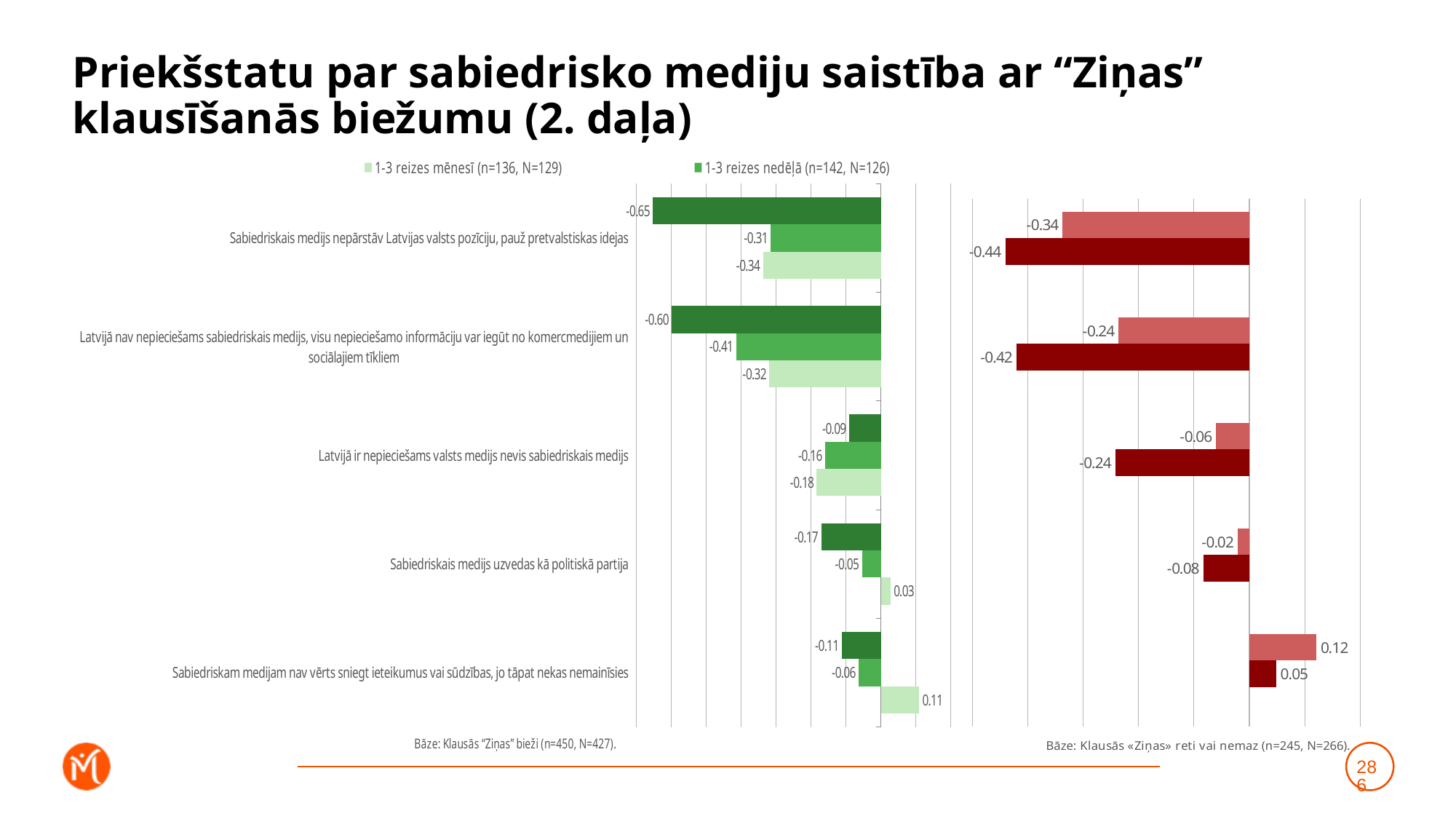
In the left chart, what is the value of the "1-3 reizes nedēļā" series for "Sabiedriskais medijs nepārstāv Latvijas valsts pozīciju, pauž pretvalstiskas idejas"? -0.31 In the right chart, what is the difference between the darker red bar (-0.44) and the lighter red bar (-0.34) for "Sabiedriskais medijs nepārstāv Latvijas valsts pozīciju, pauž pretvalstiskas idejas"? 0.10 In the right chart, what is the value of the lighter red bar for "Sabiedriskam medijam nav vērts sniegt ieteikumus vai sūdzības, jo tāpat nekas nemainīsies"? 0.12 In the left chart, which category has the highest value for the "1-3 reizes mēnesī" series? Sabiedriskam medijam nav vērts sniegt ieteikumus vai sūdzības, jo tāpat nekas nemainīsies How many categories (statements) are shown in the left chart? 5 In the left chart, for "Latvijā ir nepieciešams valsts medijs nevis sabiedriskais medijs", which is larger: the "1-3 reizes nedēļā" value or the "1-3 reizes mēnesī" value? 1-3 reizes nedēļā In the left chart, what is the value of the "1-3 reizes mēnesī" series for "Latvijā nav nepieciešams sabiedriskais medijs, visu nepieciešamo informāciju var iegūt no komercmedijiem un sociālajiem tīkliem"? -0.32 How many series does the legend above the charts list? 2 In the right chart, what is the value of the darker red bar for "Latvijā ir nepieciešams valsts medijs nevis sabiedriskais medijs"? -0.24 In the left chart, which category has the lowest value for the "1-3 reizes nedēļā" series? Latvijā nav nepieciešams sabiedriskais medijs, visu nepieciešamo informāciju var iegūt no komercmedijiem un sociālajiem tīkliem In the left chart, what is the value of the "1-3 reizes mēnesī" series for "Sabiedriskam medijam nav vērts sniegt ieteikumus vai sūdzības, jo tāpat nekas nemainīsies"? 0.11 What type of chart is used on this slide? Bar chart